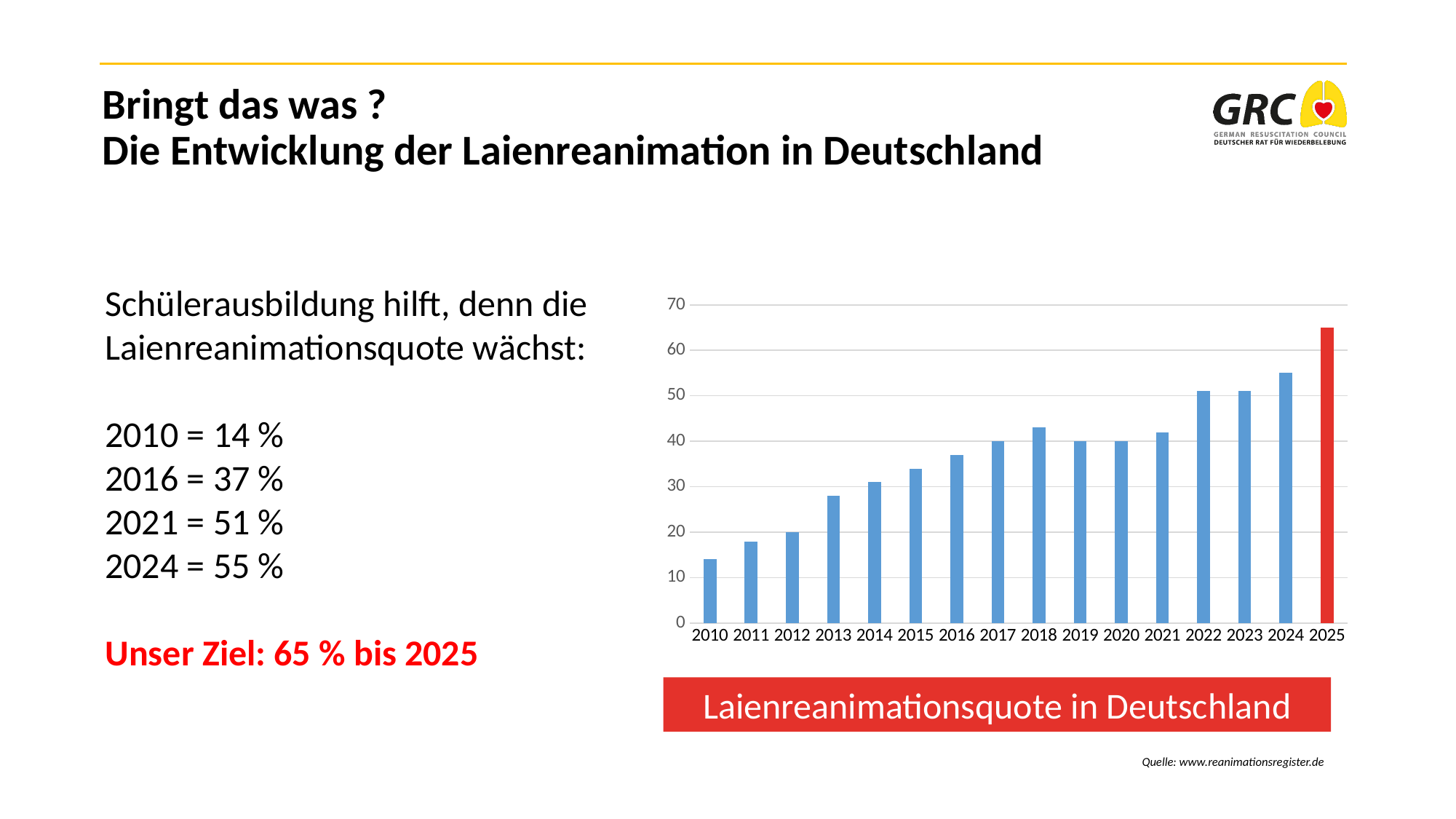
What is the Laienreanimationsquote for 2024? 55 % Is the value for 2013 greater or less than 30? less What is the title shown in the red box below the chart? Laienreanimationsquote in Deutschland How many years are shown on the x axis of the chart? 16 What is the difference between the values for 2024 and 2010? 41 % Which year has the lowest bar in the chart? 2010 Which year has the larger value, 2022 or 2018? 2022 Which year has the highest bar in the chart? 2025 What is the Laienreanimationsquote for 2016? 37 % What is the Laienreanimationsquote for 2010? 14 % Do the values generally rise or fall from 2010 to 2025? rise What type of chart is shown on the slide? bar chart